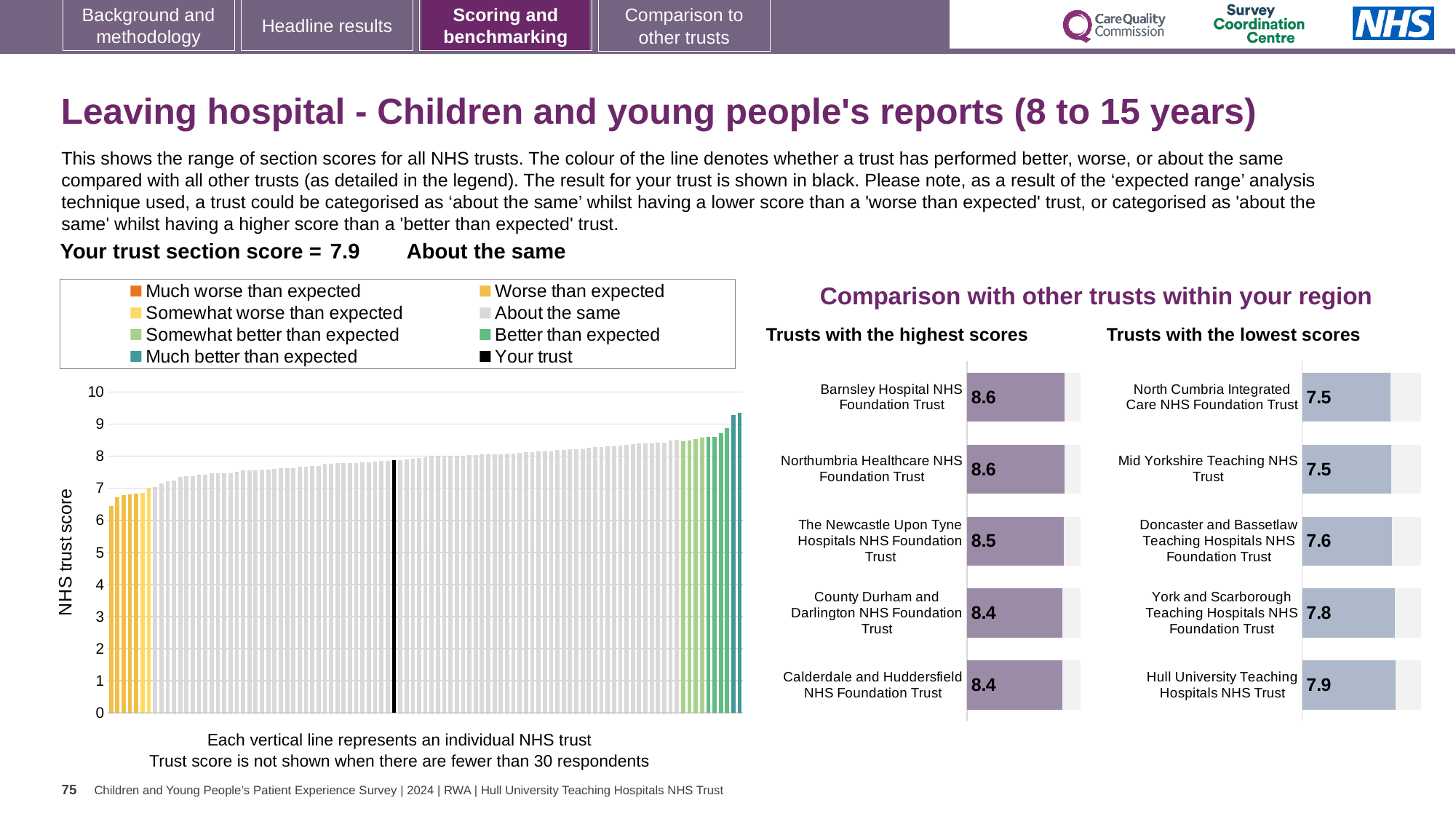
In the 'Trusts with the highest scores' chart, what is the score for The Newcastle Upon Tyne Hospitals NHS Foundation Trust? 8.5 In the 'Trusts with the highest scores' chart, what is the difference between the scores of Barnsley Hospital NHS Foundation Trust and County Durham and Darlington NHS Foundation Trust? 0.2 In the 'Trusts with the highest scores' chart, what is the score for Barnsley Hospital NHS Foundation Trust? 8.6 In the 'Trusts with the lowest scores' chart, which has the larger score: York and Scarborough Teaching Hospitals NHS Foundation Trust or Mid Yorkshire Teaching NHS Trust? York and Scarborough Teaching Hospitals NHS Foundation Trust What kind of chart is the large chart on the left showing all NHS trusts? bar chart In the large chart on the left showing all NHS trusts, do the values rise or fall from left to right along the x axis? rise In the 'Trusts with the lowest scores' chart, which trust has the highest score? Hull University Teaching Hospitals NHS Trust In the 'Trusts with the lowest scores' chart, what is the score for Doncaster and Bassetlaw Teaching Hospitals NHS Foundation Trust? 7.6 How many trusts are listed in the 'Trusts with the highest scores' chart? 5 How many entries does the legend above the large chart on the left list? 8 In the 'Trusts with the lowest scores' chart, what is the difference between the scores of Hull University Teaching Hospitals NHS Trust and North Cumbria Integrated Care NHS Foundation Trust? 0.4 In the large chart on the left showing all NHS trusts, is the value for the lowest-scoring trust greater or less than 6? greater